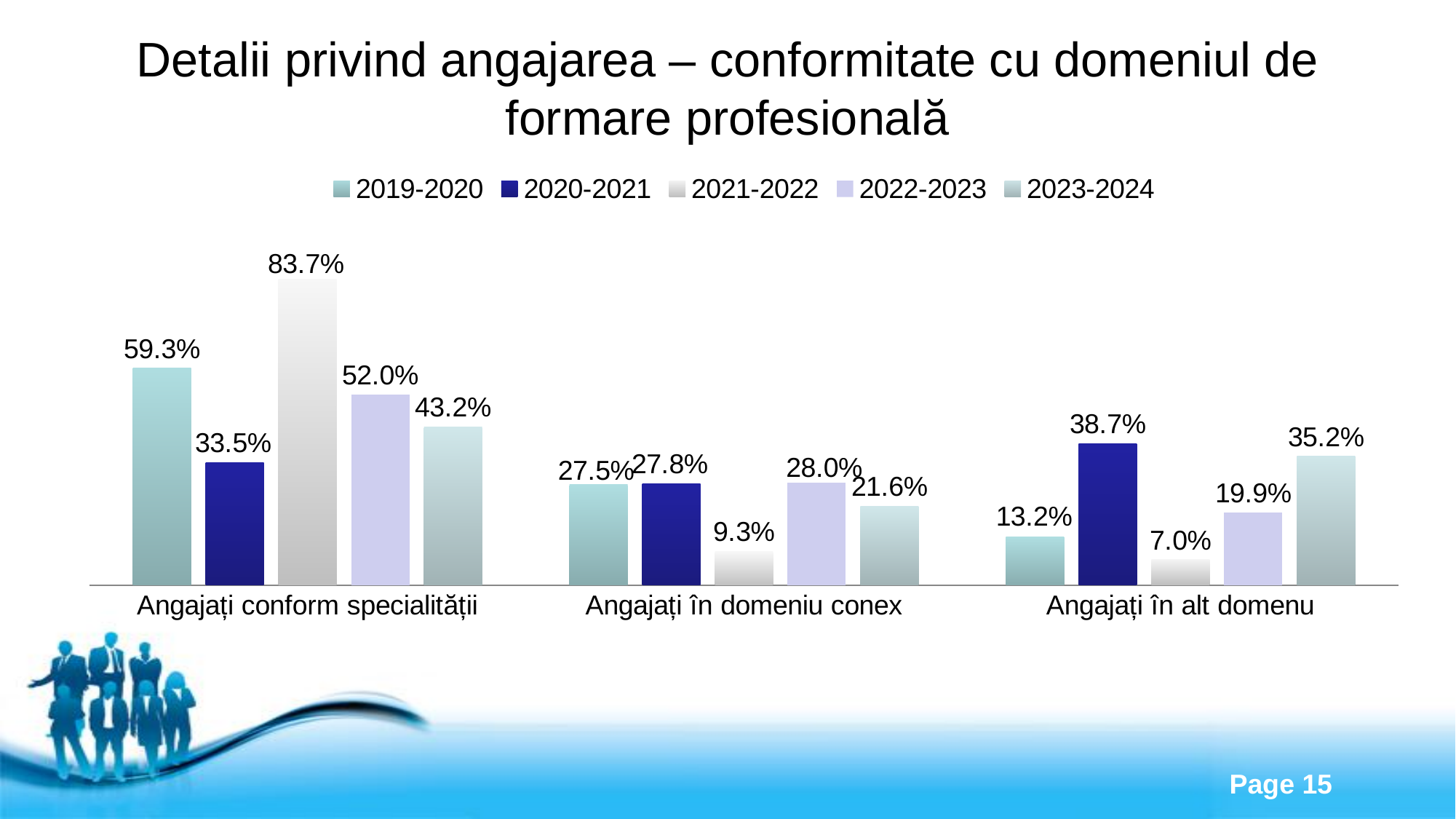
What kind of chart is shown on the slide? Bar chart What is the value for 2023-2024 in the 'Angajați în alt domenu' category? 35.2% What is the difference between the 2021-2022 and 2019-2020 values in the 'Angajați conform specialității' category? 24.4% Which series has the lowest value in the 'Angajați conform specialității' category? 2020-2021 Which series is shown in dark blue in the legend? 2020-2021 What is the difference between the 2020-2021 and 2021-2022 values in the 'Angajați în alt domenu' category? 31.7% How many categories are shown on the x axis? 3 What is the value for 2021-2022 in the 'Angajați conform specialității' category? 83.7% What is the value for 2021-2022 in the 'Angajați în domeniu conex' category? 9.3% Which series has the highest value in the 'Angajați în alt domenu' category? 2020-2021 Which is larger in the 'Angajați în alt domenu' category: the 2022-2023 value or the 2019-2020 value? 2022-2023 How many series does the legend list? 5